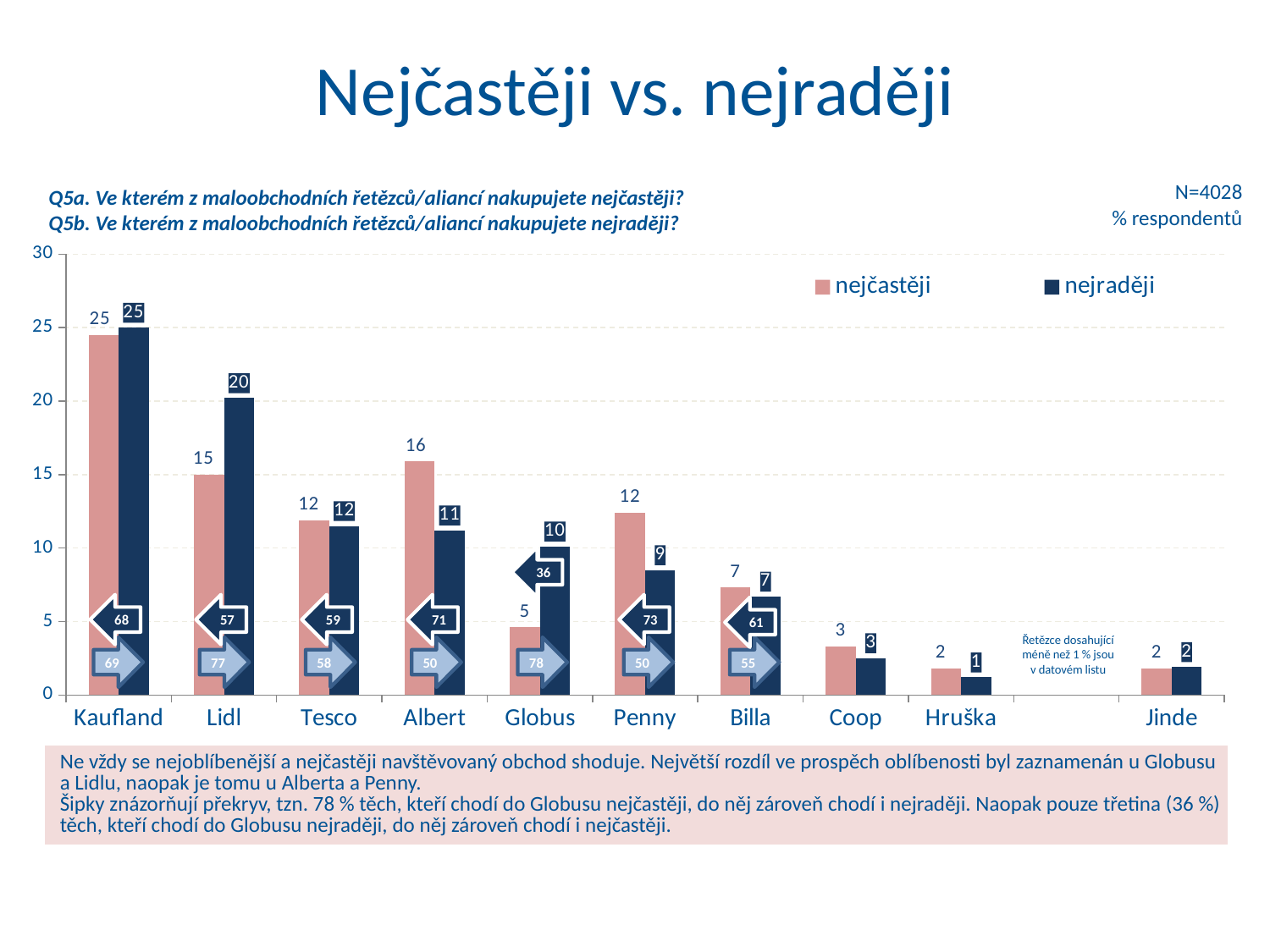
What is the value for Albert in the nejčastěji series? 16 Which category has the highest value in the nejraději series? Kaufland What is the sample size (N) stated on the slide? N=4028 What is the difference between the nejraději and nejčastěji values for Globus? 5 What is the value for Globus in the nejčastěji series? 5 Which is larger for Penny: the nejčastěji value or the nejraději value? nejčastěji What kind of chart is shown on the slide? bar chart Which category has the lowest value in the nejraději series? Hruška How many series does the legend list? 2 What is the difference between the nejčastěji and nejraději values for Albert? 5 How many categories are shown on the x axis of the chart? 10 What is the value for Lidl in the nejraději series? 20